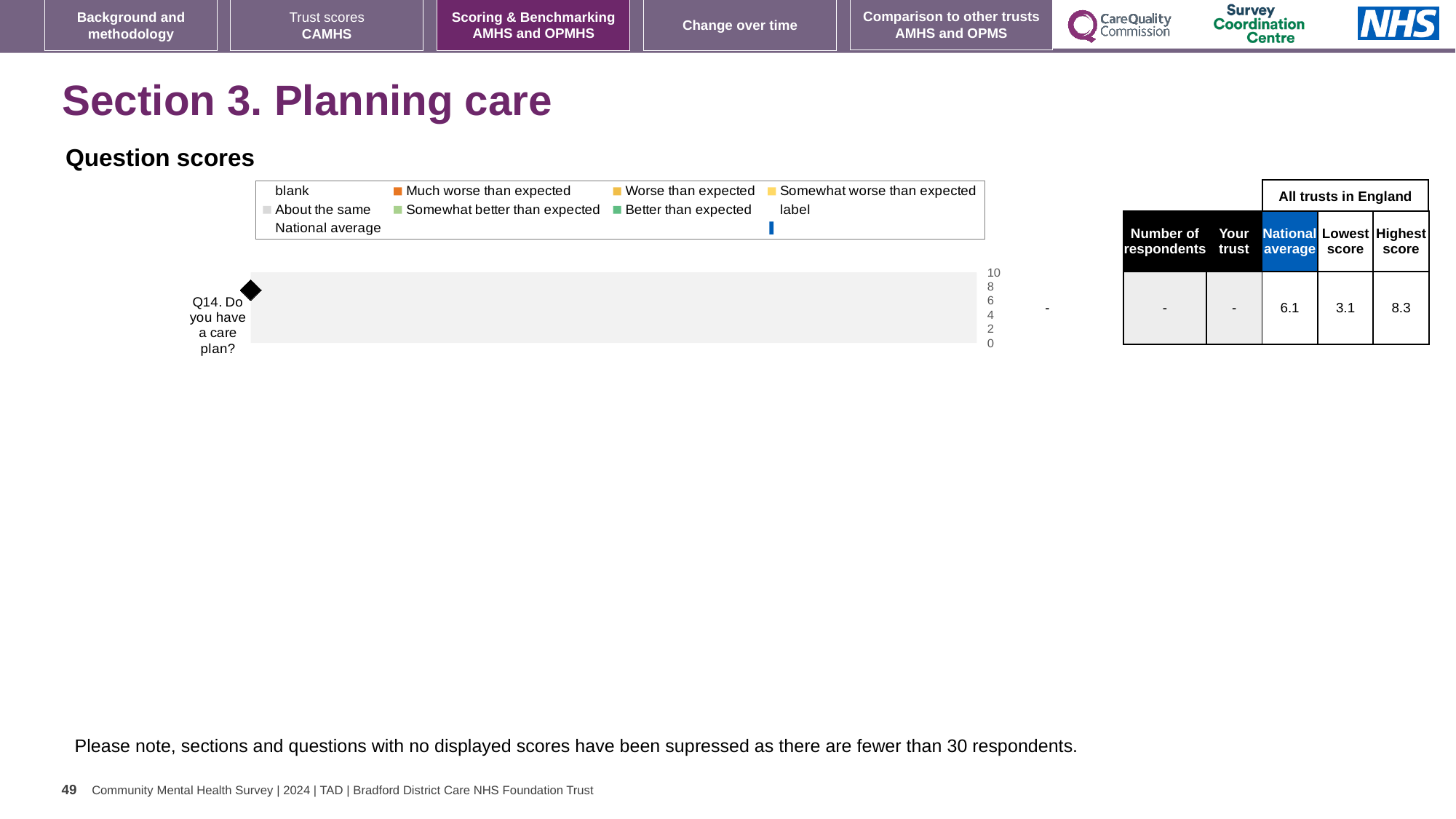
Is the National average for Q14 larger or smaller than the Lowest score? larger What value is shown for Your trust for Q14 in the table? - In the table next to the chart, what is the National average score for Q14? 6.1 What is the maximum value shown on the chart's axis scale? 10 What is the label of the single category on the chart's y axis? Q14. Do you have a care plan? In the table next to the chart, what is the Highest score for Q14 across all trusts in England? 8.3 What is the difference between the Highest score and the Lowest score for Q14 in the table? 5.2 How many question categories are plotted on the chart? 1 In the table next to the chart, what is the Lowest score for Q14 across all trusts in England? 3.1 What kind of chart is shown on the slide? bar chart